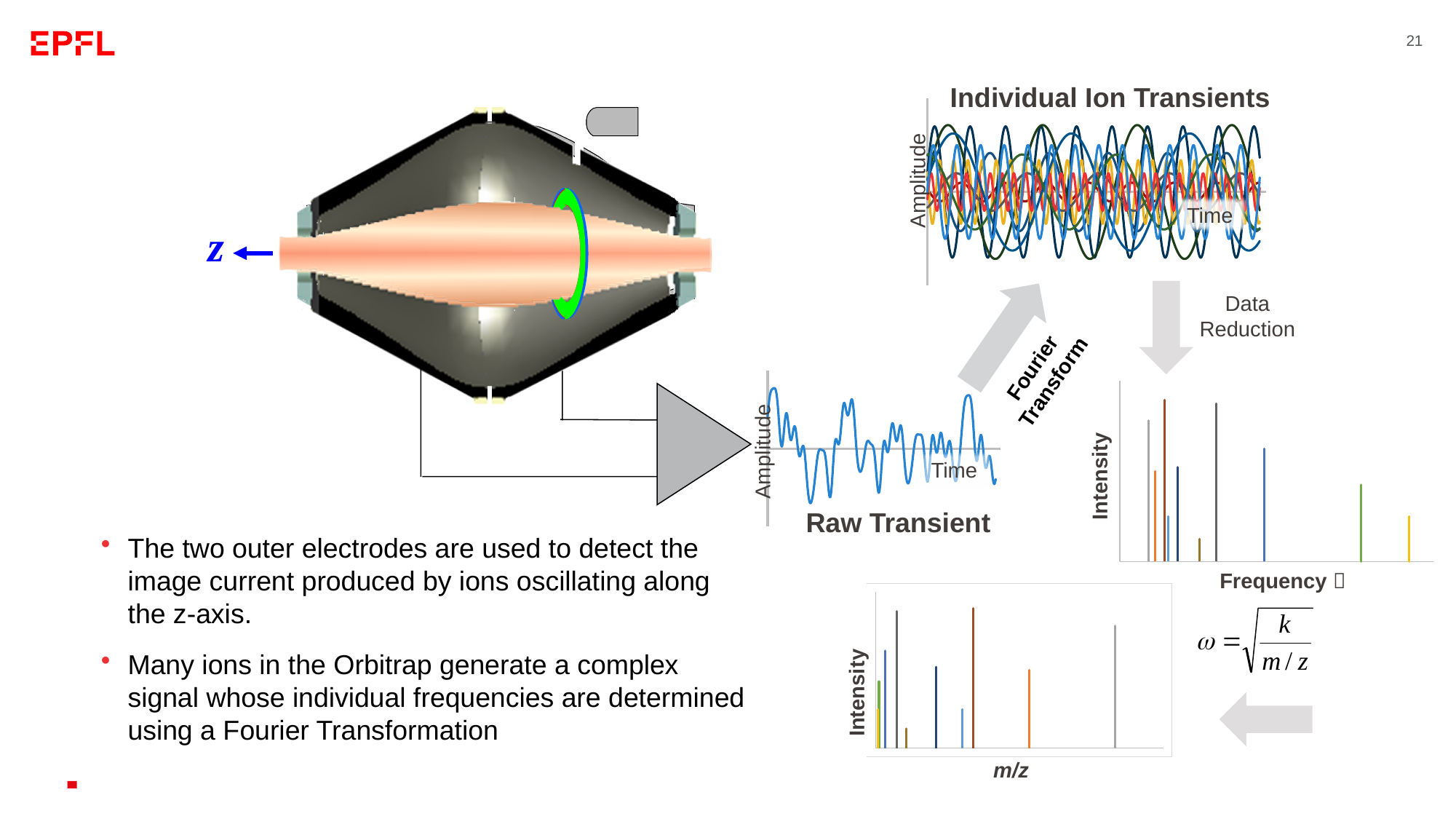
What is the x-axis label of the 'Individual Ion Transients' chart? Time What is the y-axis label of the 'Raw Transient' chart? Amplitude What kind of chart is the 'Individual Ion Transients' chart? line chart What kind of chart is the 'Raw Transient' chart? line chart What is the x-axis label of the chart at the bottom of the slide with the 'Intensity' y-axis? m/z What is the title of the chart in the top right of the slide? Individual Ion Transients